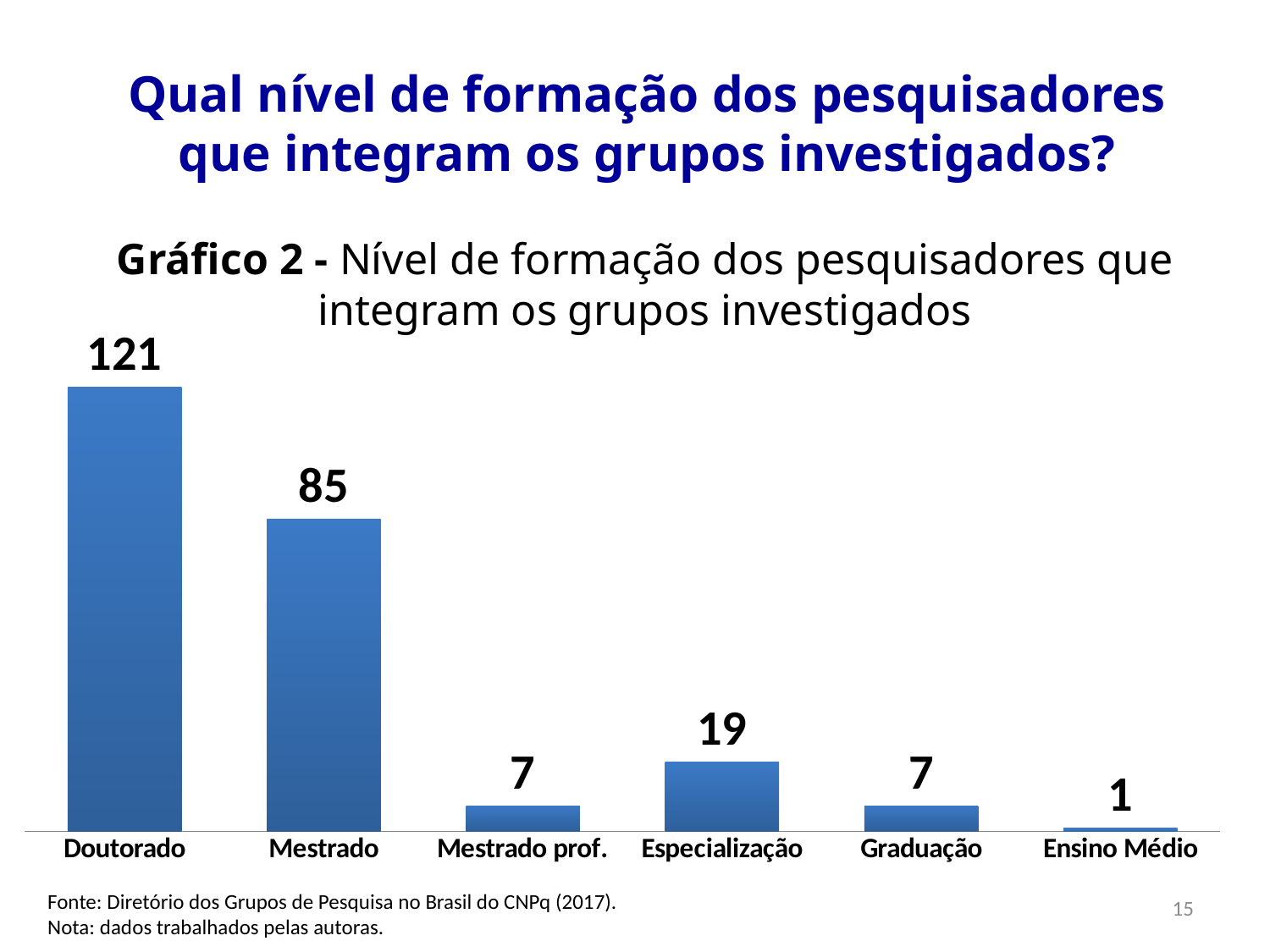
What is the value for Ensino Médio? 1 What is the value for Mestrado? 85 What is the value for Especialização? 19 What is the value for Doutorado? 121 What kind of chart is shown on the slide? Bar chart What is the title of the chart? Gráfico 2 - Nível de formação dos pesquisadores que integram os grupos investigados What is the difference between the values for Especialização and Graduação? 12 Which is larger, the value for Especialização or the value for Mestrado prof.? Especialização Which category has the lowest value? Ensino Médio How many categories are shown in the chart? 6 Which category has the highest value? Doutorado What is the difference between the values for Doutorado and Mestrado? 36